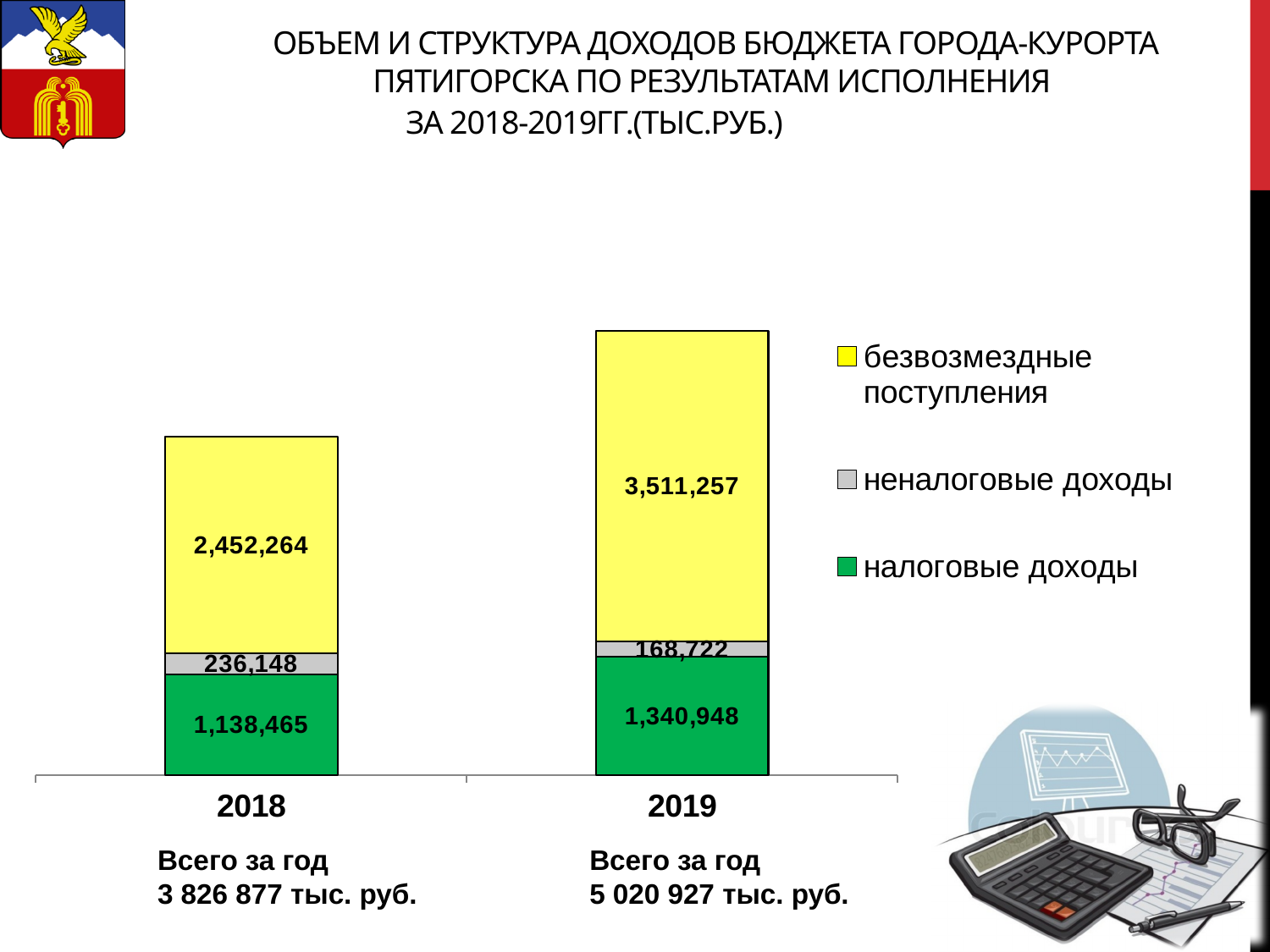
What type of chart is shown on the slide? stacked bar chart What is the value of неналоговые доходы for 2019? 168,722 What is the value of налоговые доходы for 2018? 1,138,465 What is the total of the stacked bar for 2019? 5 020 927 тыс. руб. By how much did налоговые доходы increase from 2018 to 2019? 202,483 What is the difference in неналоговые доходы between 2018 and 2019? 67,426 Which year has the larger value for безвозмездные поступления, 2018 or 2019? 2019 What is the value of безвозмездные поступления for 2019? 3,511,257 Which colour represents налоговые доходы in the chart? green What is the total of the stacked bar for 2018? 3 826 877 тыс. руб. How many series does the legend list? 3 How many categories (years) are shown on the x axis? 2